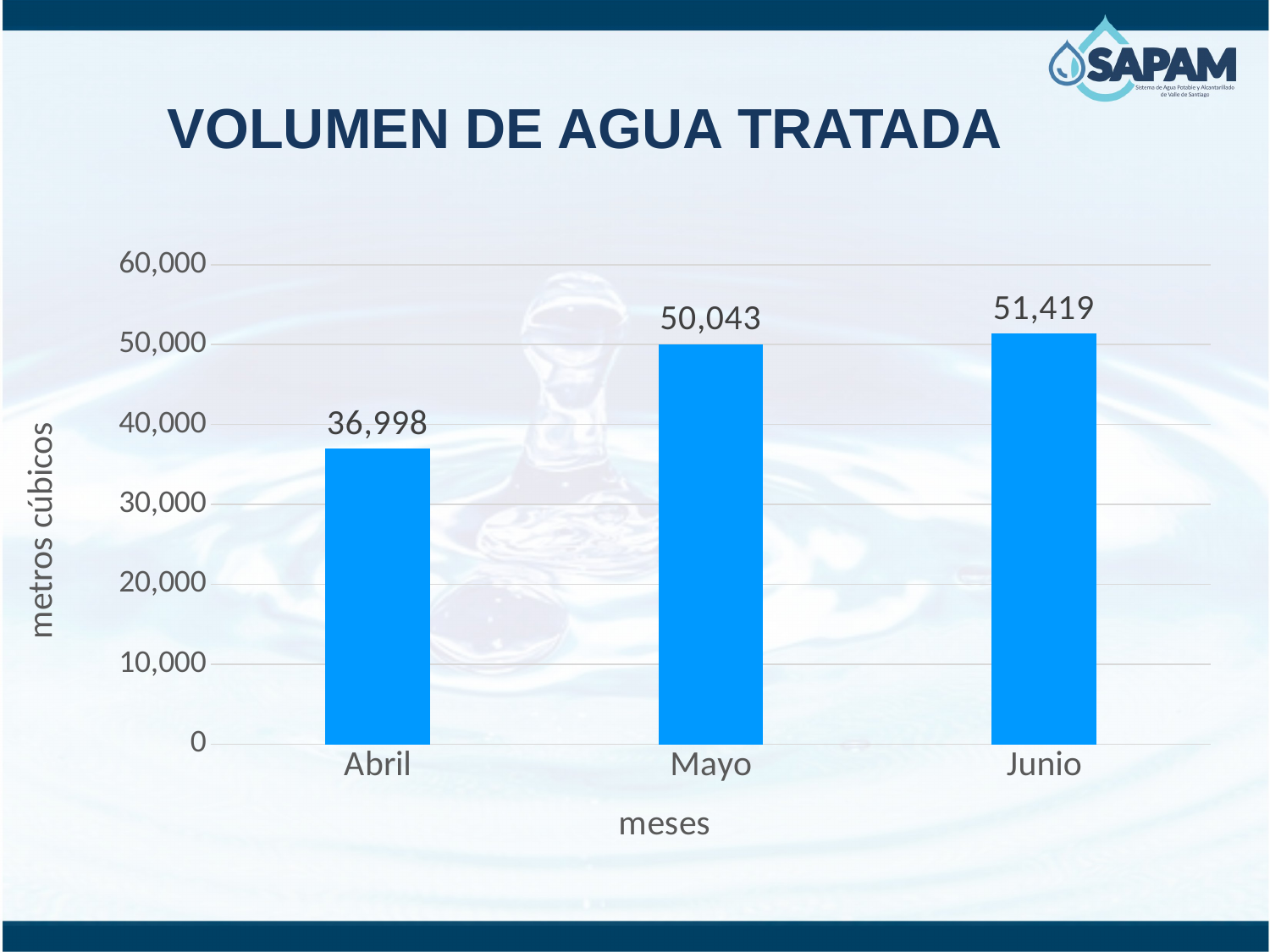
Which month has the highest volume of treated water? Junio What is the value for Junio? 51,419 Which is larger, the value for Abril or the value for Mayo? Mayo Is the value for Abril greater or less than 40,000? less What is the difference between the values for Mayo and Abril? 13,045 What is the difference between the values for Junio and Mayo? 1,376 What kind of chart is shown on the slide? bar chart Do the values rise or fall from Abril to Junio? rise How many months are shown on the x axis? 3 Which month has the lowest volume of treated water? Abril What is the value for Mayo? 50,043 What is the value for Abril? 36,998